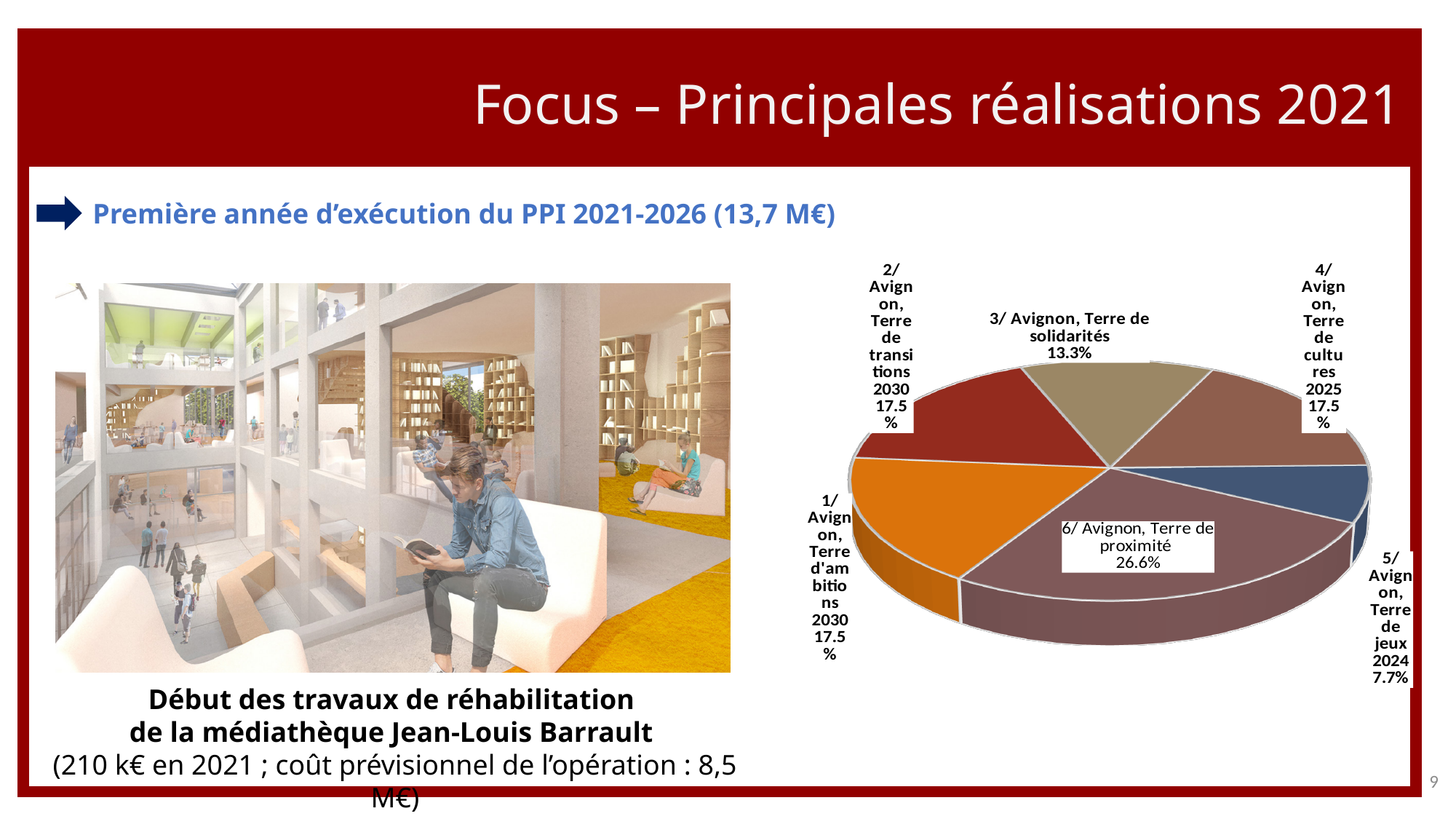
Which slice of the pie chart is the largest? 6/ Avignon, Terre de proximité What share of the pie does "5/ Avignon, Terre de jeux 2024" represent? 7.7% What is the difference in percentage points between "6/ Avignon, Terre de proximité" and "5/ Avignon, Terre de jeux 2024"? 18.9 Which slice of the pie chart is the smallest? 5/ Avignon, Terre de jeux 2024 What share of the pie does "6/ Avignon, Terre de proximité" represent? 26.6% What is the combined share of "2/ Avignon, Terre de transitions 2030" and "3/ Avignon, Terre de solidarités"? 30.8% What share of the pie does "1/ Avignon, Terre d'ambitions 2030" represent? 17.5% Which is larger: the share for "3/ Avignon, Terre de solidarités" or the share for "4/ Avignon, Terre de cultures 2025"? 4/ Avignon, Terre de cultures 2025 How many slices of the pie chart have a share of 17.5%? 3 What share of the pie does "3/ Avignon, Terre de solidarités" represent? 13.3% How many slices does the pie chart have? 6 What kind of chart is shown on the slide? pie chart